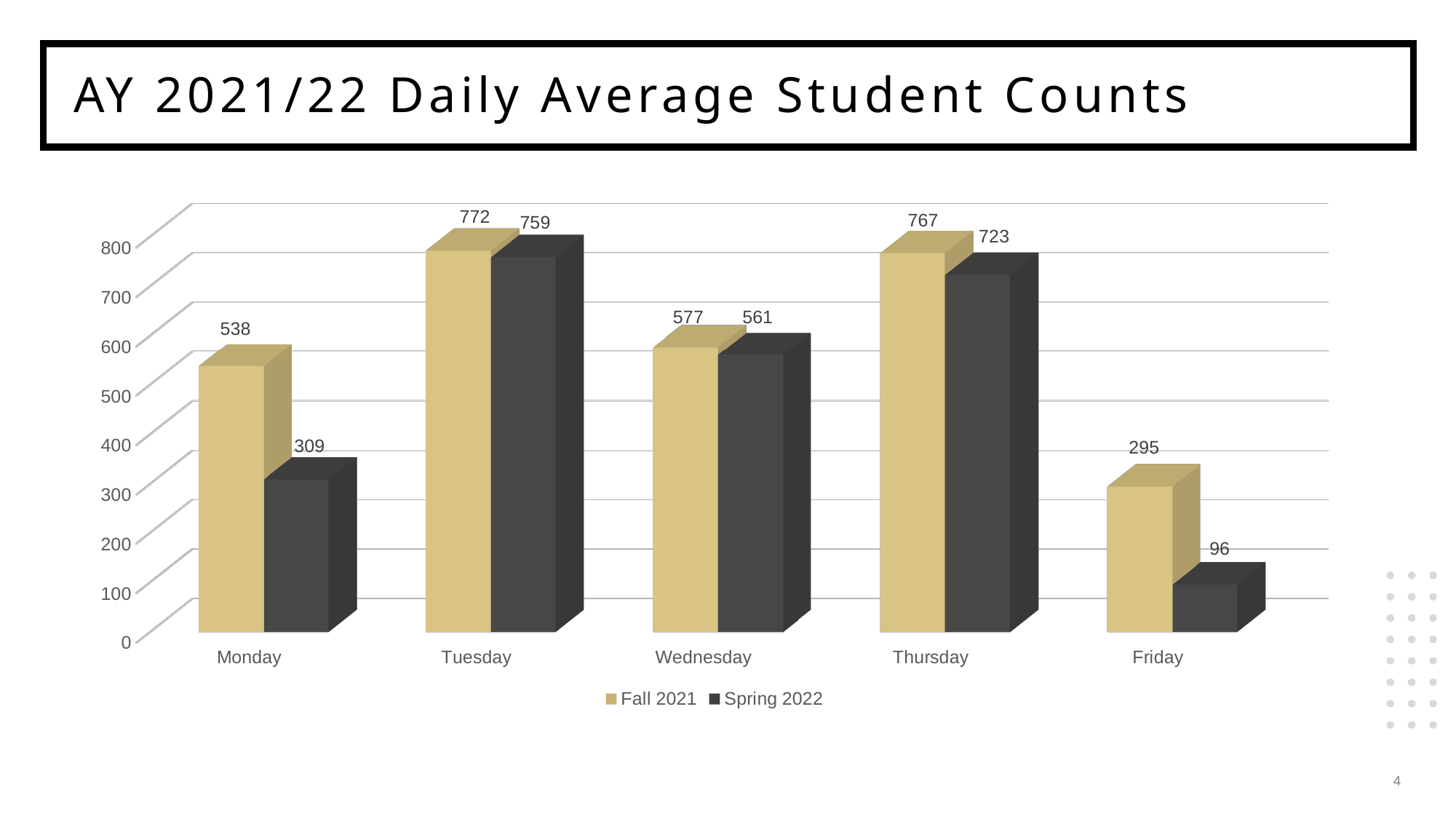
Which day has the highest Fall 2021 daily average student count? Tuesday What is the Spring 2022 value for Thursday? 723 Which day has the lowest Spring 2022 daily average student count? Friday What is the Spring 2022 daily average student count for Friday? 96 Which series is shown in the dark grey bars? Spring 2022 Which is larger for Wednesday, the Fall 2021 value or the Spring 2022 value? Fall 2021 How many series does the legend list? 2 What is the Fall 2021 daily average student count for Monday? 538 What is the difference between the Tuesday and Thursday Spring 2022 values? 36 How many days are shown on the x axis? 5 What kind of chart is shown on the slide? Bar chart What is the difference between the Fall 2021 and Spring 2022 values for Monday? 229